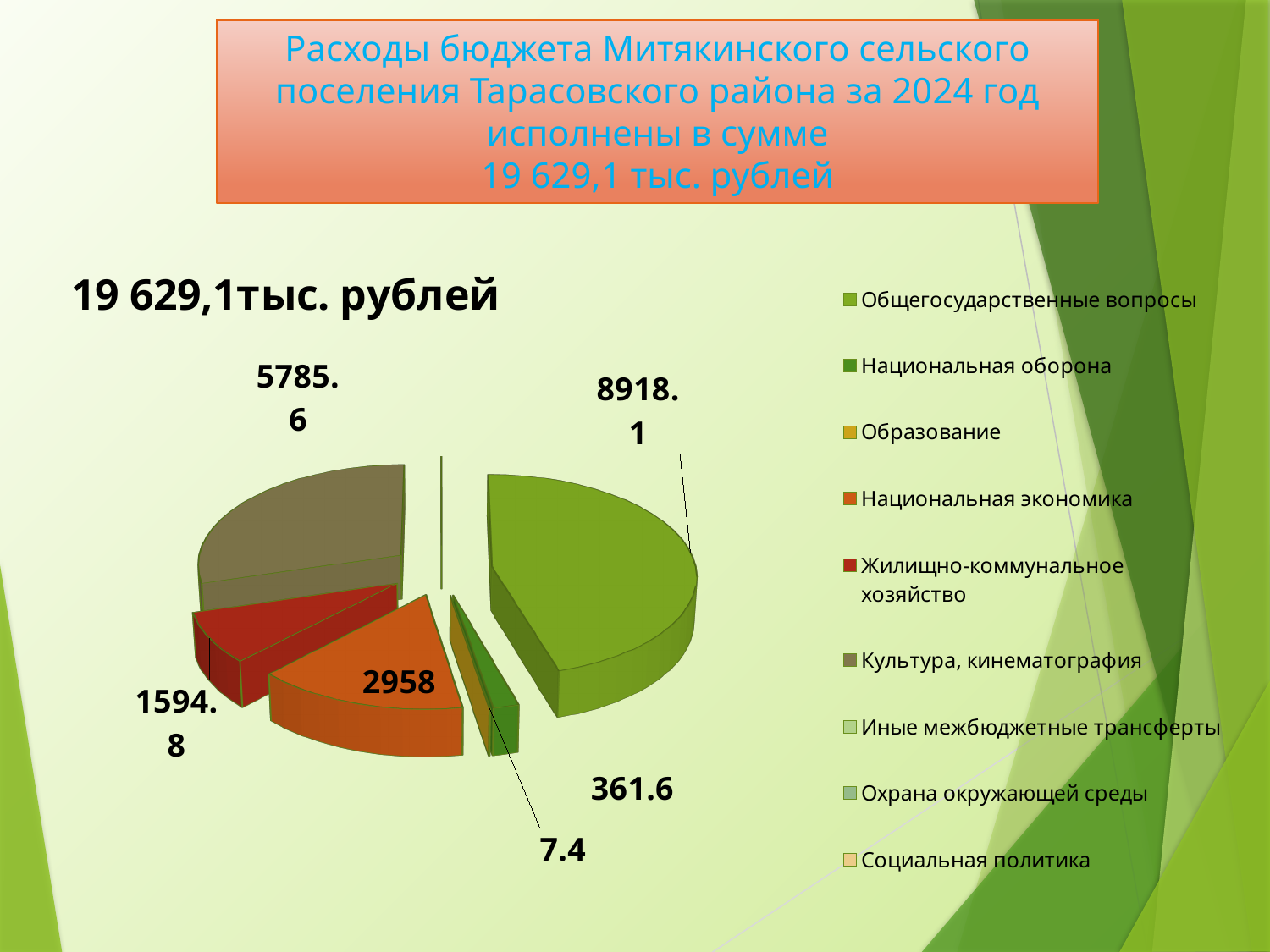
What is the value shown for Общегосударственные вопросы on the pie chart? 8918.1 Which is larger: the value for Национальная экономика or the value for Жилищно-коммунальное хозяйство? Национальная экономика What is the value shown for Национальная оборона on the pie chart? 361.6 Which labelled category has the smallest value on the pie chart? Образование What is the value shown for Национальная экономика on the pie chart? 2958 What kind of chart is shown on the slide? Pie chart What is the difference between the values for Национальная экономика and Жилищно-коммунальное хозяйство? 1363.2 Which category has the largest slice of the pie chart? Общегосударственные вопросы What is the value shown for Культура, кинематография on the pie chart? 5785.6 What is the value shown for Жилищно-коммунальное хозяйство on the pie chart? 1594.8 What is the difference between the values for Общегосударственные вопросы and Культура, кинематография? 3132.5 How many entries does the legend of the pie chart list? 9